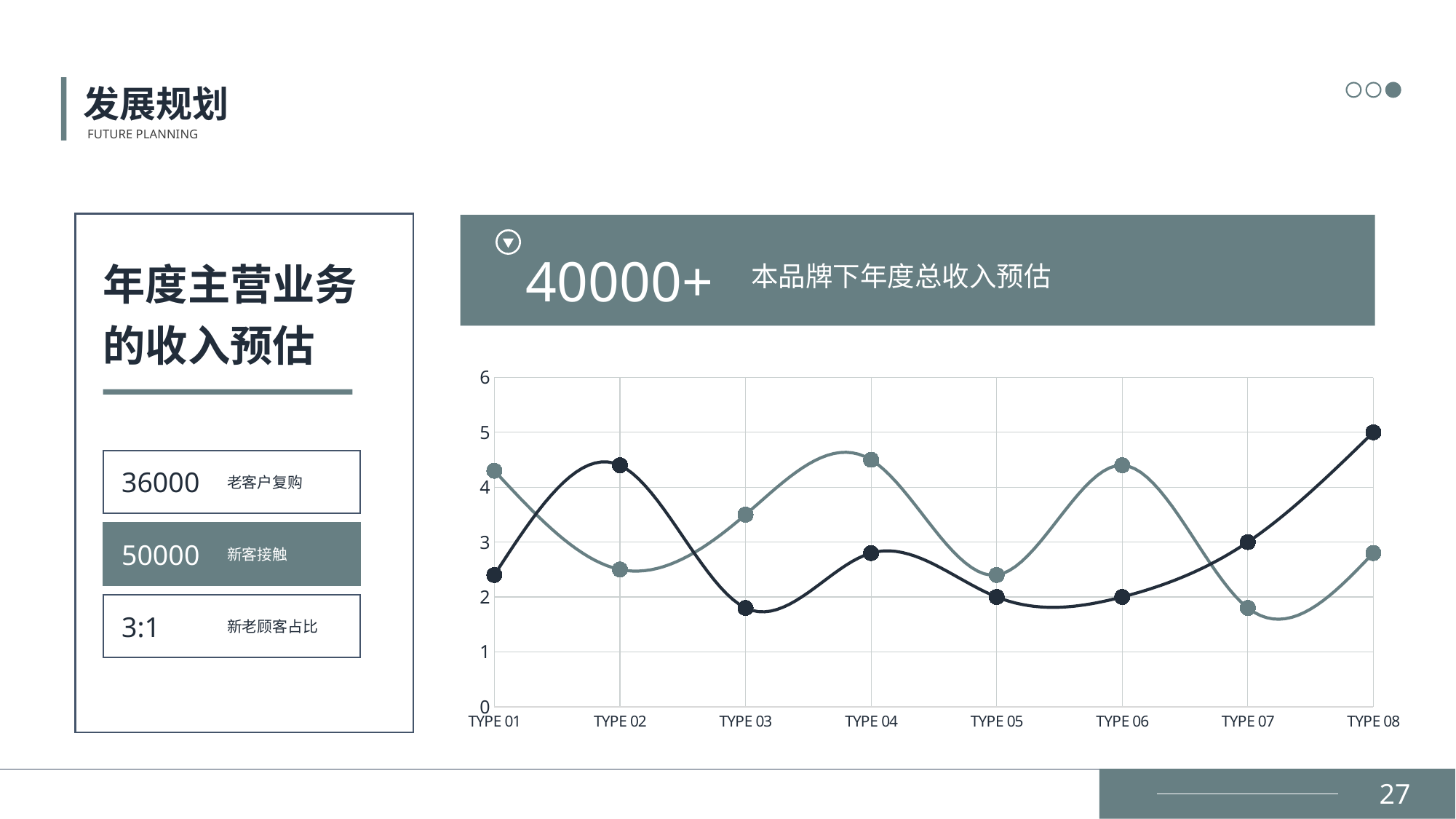
Is the value of the dark line at TYPE 05 greater or less than 3? less How many categories are shown on the x axis of the chart? 8 At TYPE 01, which line has the higher value, the dark line or the grey line? the grey line How many lines are plotted on the chart? 2 At TYPE 02, which line has the higher value, the dark line or the grey line? the dark line At which category does the grey line reach its lowest value? TYPE 07 Is the value of the grey line at TYPE 04 greater or less than 4? greater What kind of chart is shown on the slide? line chart Is the value of the grey line at TYPE 01 greater or less than 4? greater Does the dark line rise or fall from TYPE 06 to TYPE 08? rise At which category does the dark line reach its highest value? TYPE 08